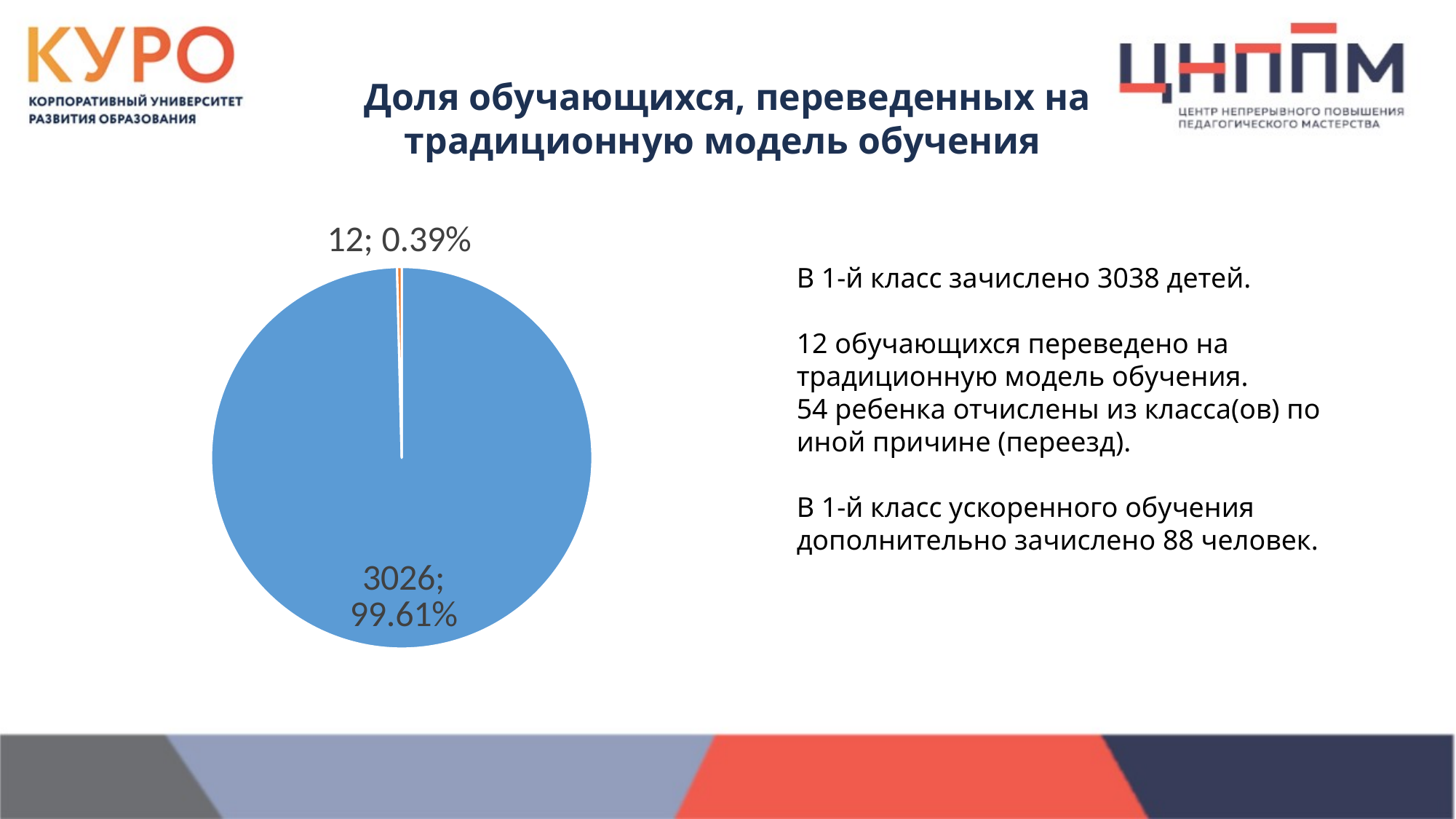
What share of the pie does the large blue slice represent? 99.61% What kind of chart is shown on the slide? pie chart What is the difference between the values of the two slices in the pie chart? 3014 What is the title of the chart on the slide? Доля обучающихся, переведенных на традиционную модель обучения Which slice is larger, the blue one or the orange one? the blue one Which slice of the pie chart has the smallest value? the orange slice (12) What value is labelled on the large blue slice of the pie chart? 3026 Which slice of the pie chart has the largest value? the blue slice (3026) What value is labelled on the small orange slice of the pie chart? 12 What is the total of the two values shown in the pie chart? 3038 How many slices does the pie chart have? 2 What share of the pie does the small orange slice represent? 0.39%